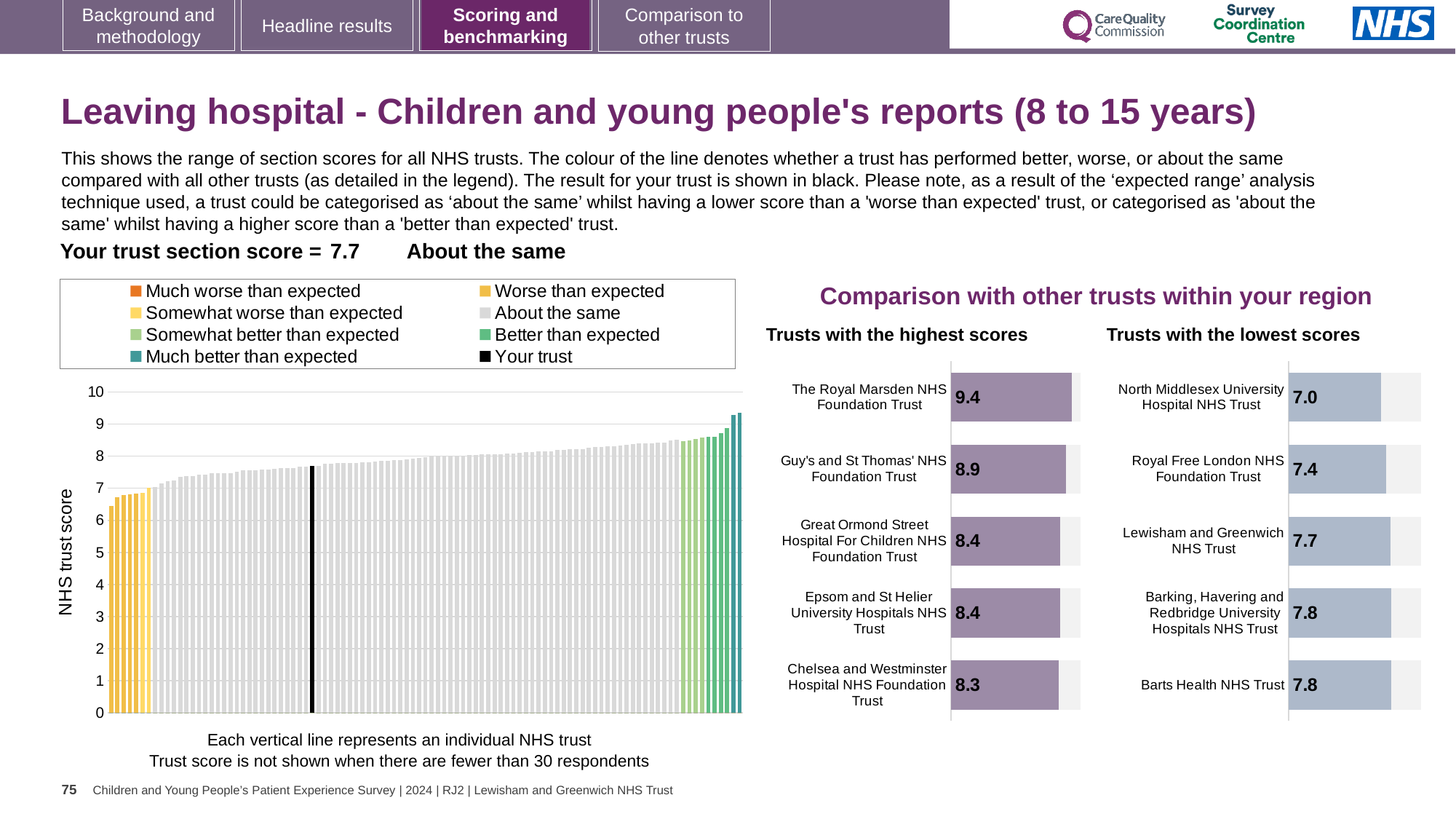
In the large chart on the left showing the range of section scores, what kind of chart is it? Bar chart In the 'Trusts with the lowest scores' chart, which trust has the lowest score? North Middlesex University Hospital NHS Trust In the 'Trusts with the lowest scores' chart, which has the larger score: Royal Free London NHS Foundation Trust or Lewisham and Greenwich NHS Trust? Lewisham and Greenwich NHS Trust In the 'Trusts with the highest scores' chart, what is the score for The Royal Marsden NHS Foundation Trust? 9.4 In the 'Trusts with the highest scores' chart, what is the score for Guy's and St Thomas' NHS Foundation Trust? 8.9 In the 'Trusts with the lowest scores' chart, what is the difference between the scores of Royal Free London NHS Foundation Trust and North Middlesex University Hospital NHS Trust? 0.4 In the large chart on the left showing the range of section scores, how many entries does the legend list? 8 In the 'Trusts with the highest scores' chart, how many trusts are shown? 5 In the 'Trusts with the lowest scores' chart, what is the score for Lewisham and Greenwich NHS Trust? 7.7 In the 'Trusts with the highest scores' chart, which trust has the lowest score? Chelsea and Westminster Hospital NHS Foundation Trust In the 'Trusts with the highest scores' chart, what is the difference between the scores of The Royal Marsden NHS Foundation Trust and Chelsea and Westminster Hospital NHS Foundation Trust? 1.1 In the 'Trusts with the lowest scores' chart, what is the score for North Middlesex University Hospital NHS Trust? 7.0